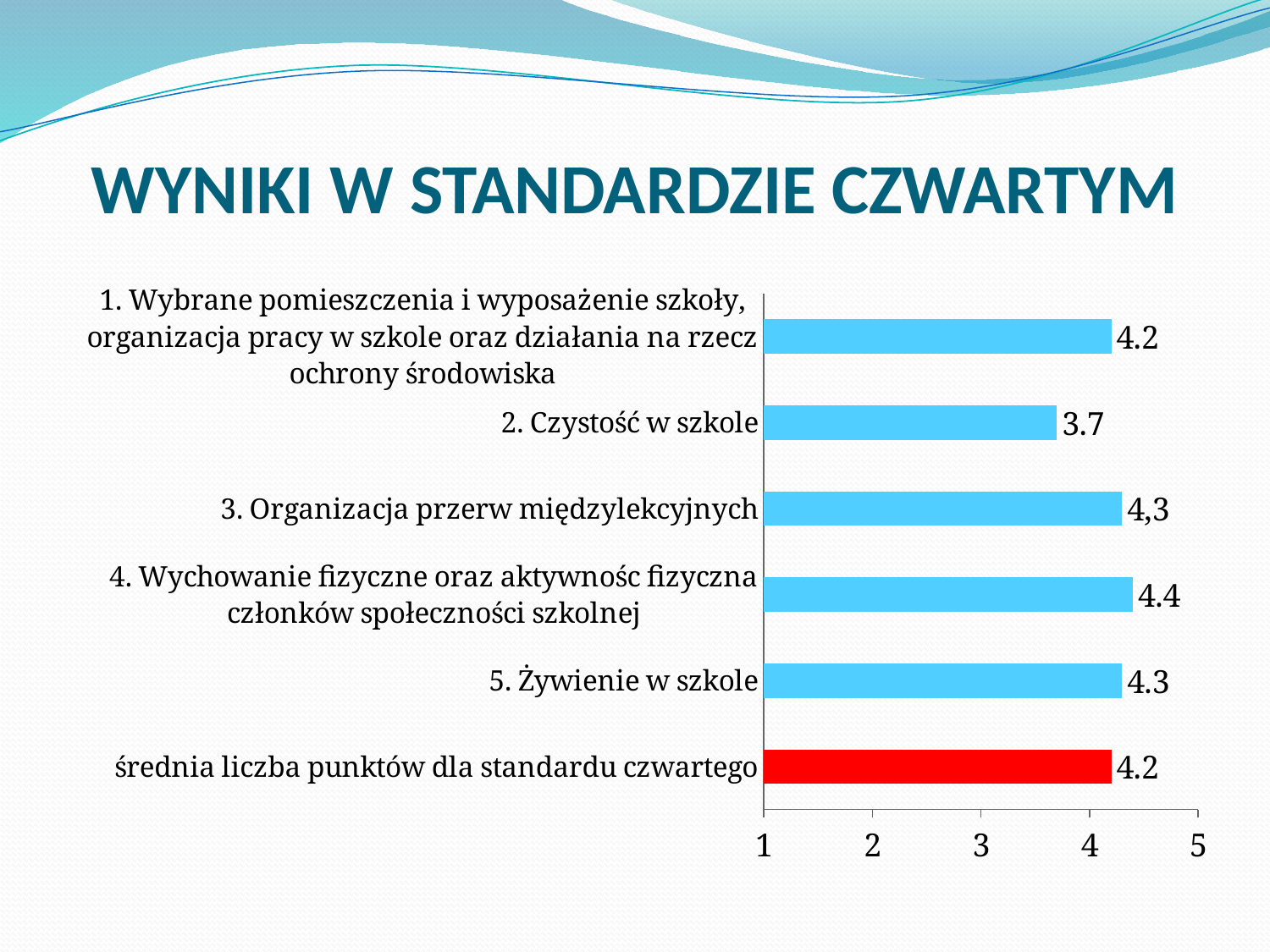
What is the value for "3. Organizacja przerw międzylekcyjnych"? 4,3 Is the value for "2. Czystość w szkole" greater or less than 4? less How many bars are shown in the chart? 6 Which category has the lowest value? 2. Czystość w szkole What is the difference between the value for "4. Wychowanie fizyczne oraz aktywnośc fizyczna członków społeczności szkolnej" and the value for "2. Czystość w szkole"? 0.7 What kind of chart is shown on the slide? bar chart Which is larger: the value for "2. Czystość w szkole" or the value for "5. Żywienie w szkole"? 5. Żywienie w szkole Which category has the highest value? 4. Wychowanie fizyczne oraz aktywnośc fizyczna członków społeczności szkolnej Which bar is coloured red? średnia liczba punktów dla standardu czwartego What is the value for "2. Czystość w szkole"? 3.7 What is the value for "5. Żywienie w szkole"? 4.3 What is the value for "średnia liczba punktów dla standardu czwartego"? 4.2